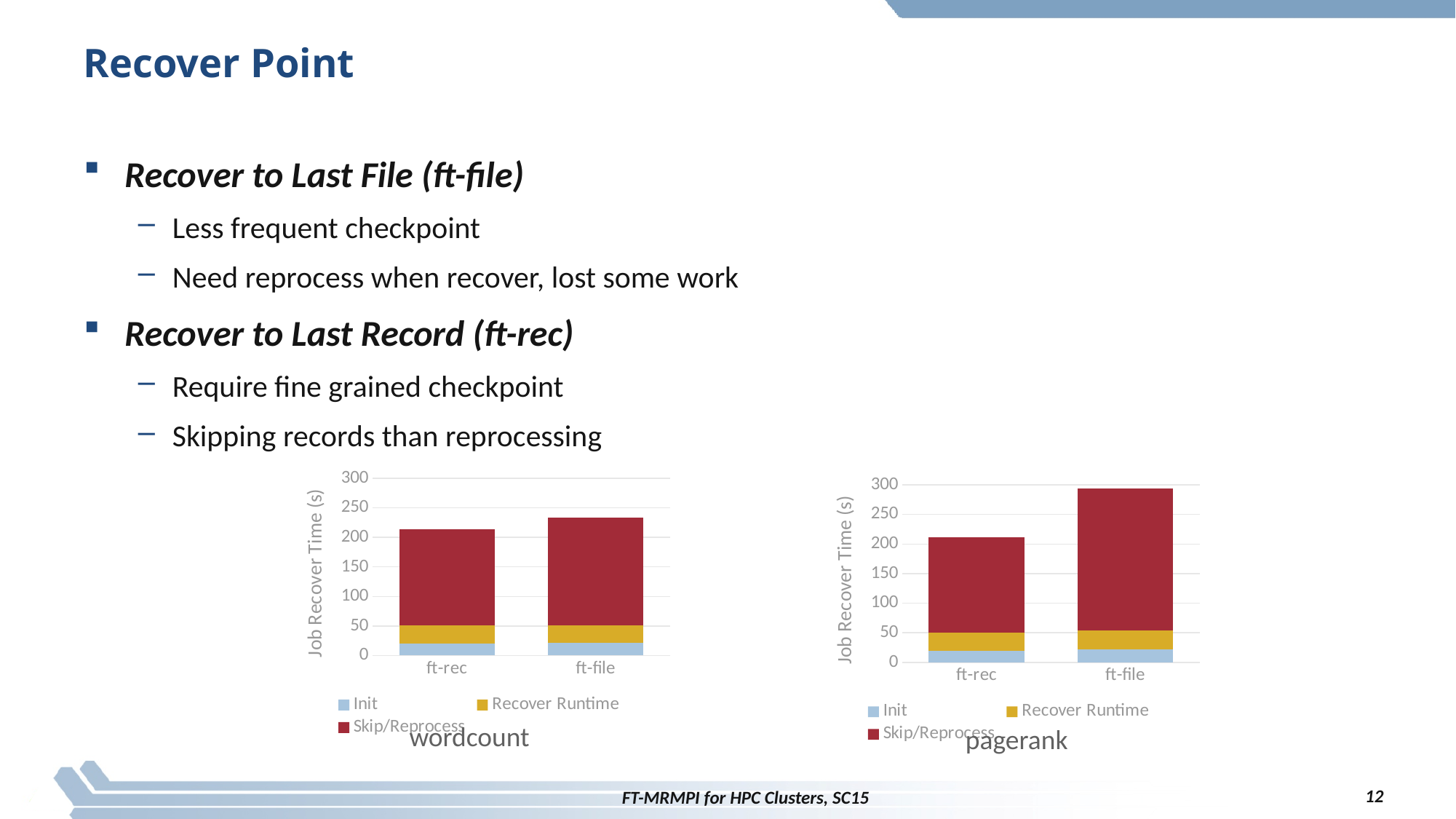
In the pagerank chart, which category has the highest total job recover time? ft-file In the wordcount chart, is the total for ft-file greater or less than 250? less What is the y-axis title of the wordcount chart? Job Recover Time (s) How many categories are shown on the x axis of the wordcount chart? 2 What kind of chart is the wordcount chart on the left? Stacked bar chart In the wordcount chart, is the total for ft-rec greater or less than 200? greater In the pagerank chart, is the total for ft-file greater or less than 250? greater In the wordcount chart, which category has the lowest total job recover time? ft-rec How many series does the legend of the pagerank chart list? 3 In the pagerank chart, which is larger, the total for ft-rec or the total for ft-file? ft-file Which series is shown in dark red in the pagerank chart's legend? Skip/Reprocess